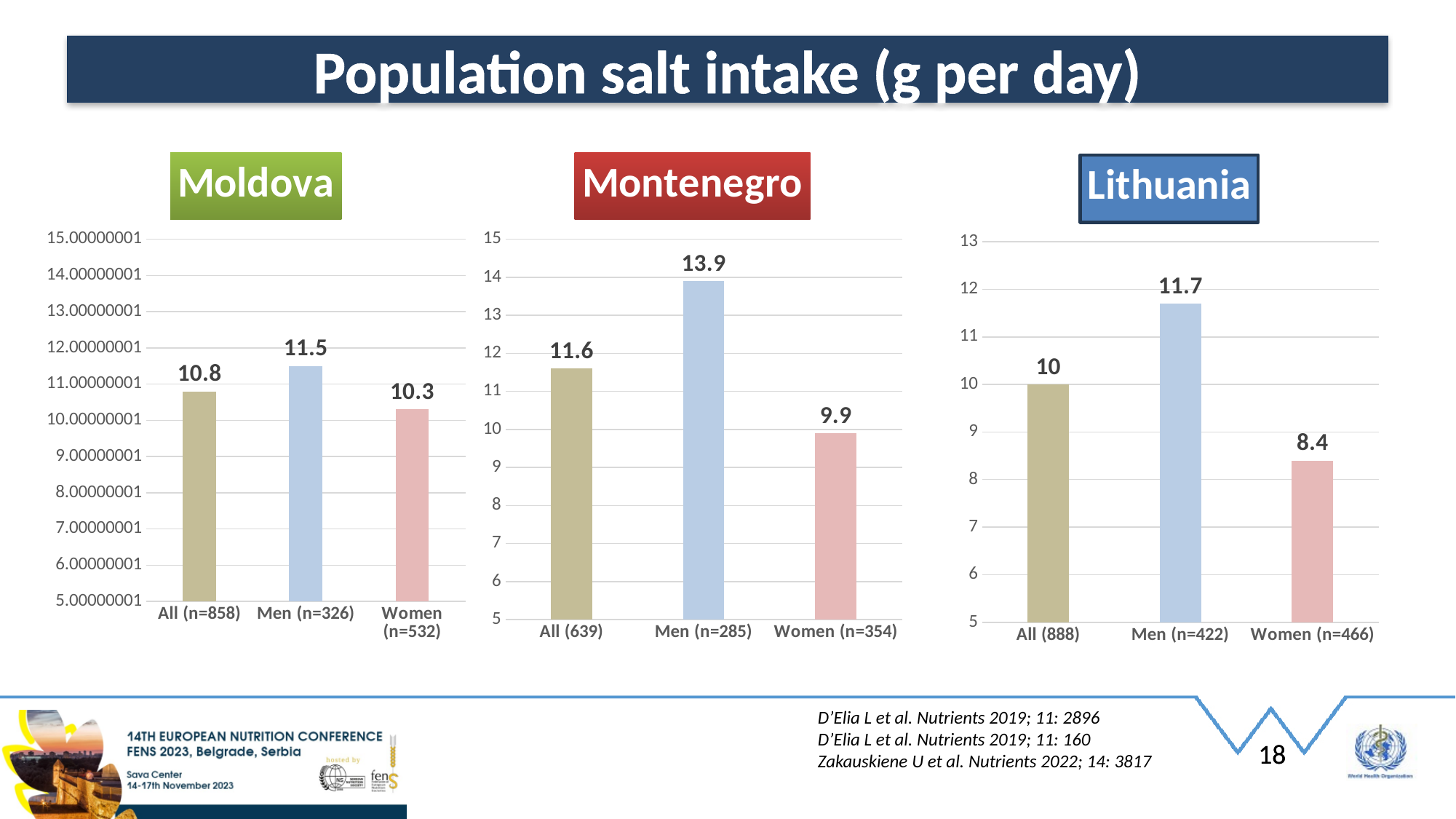
In the Moldova chart, what is the salt intake value for Men (n=326)? 11.5 What is the title of the slide containing the three charts? Population salt intake (g per day) In the Lithuania chart, what is the salt intake value for All (888)? 10 What kind of chart is used for Lithuania? bar chart In the Moldova chart, what is the difference between the Men (n=326) and Women (n=532) values? 1.2 How many bars are plotted in the Montenegro chart? 3 In the Moldova chart, is the value for All (n=858) greater or less than 10? greater In the Montenegro chart, which category has the highest salt intake? Men (n=285) In the Montenegro chart, what is the salt intake value for Women (n=354)? 9.9 In the Montenegro chart, what is the difference between the Men (n=285) and Women (n=354) values? 4 In the Lithuania chart, which is larger, the value for Men (n=422) or the value for All (888)? Men (n=422) In the Lithuania chart, which category has the lowest salt intake? Women (n=466)